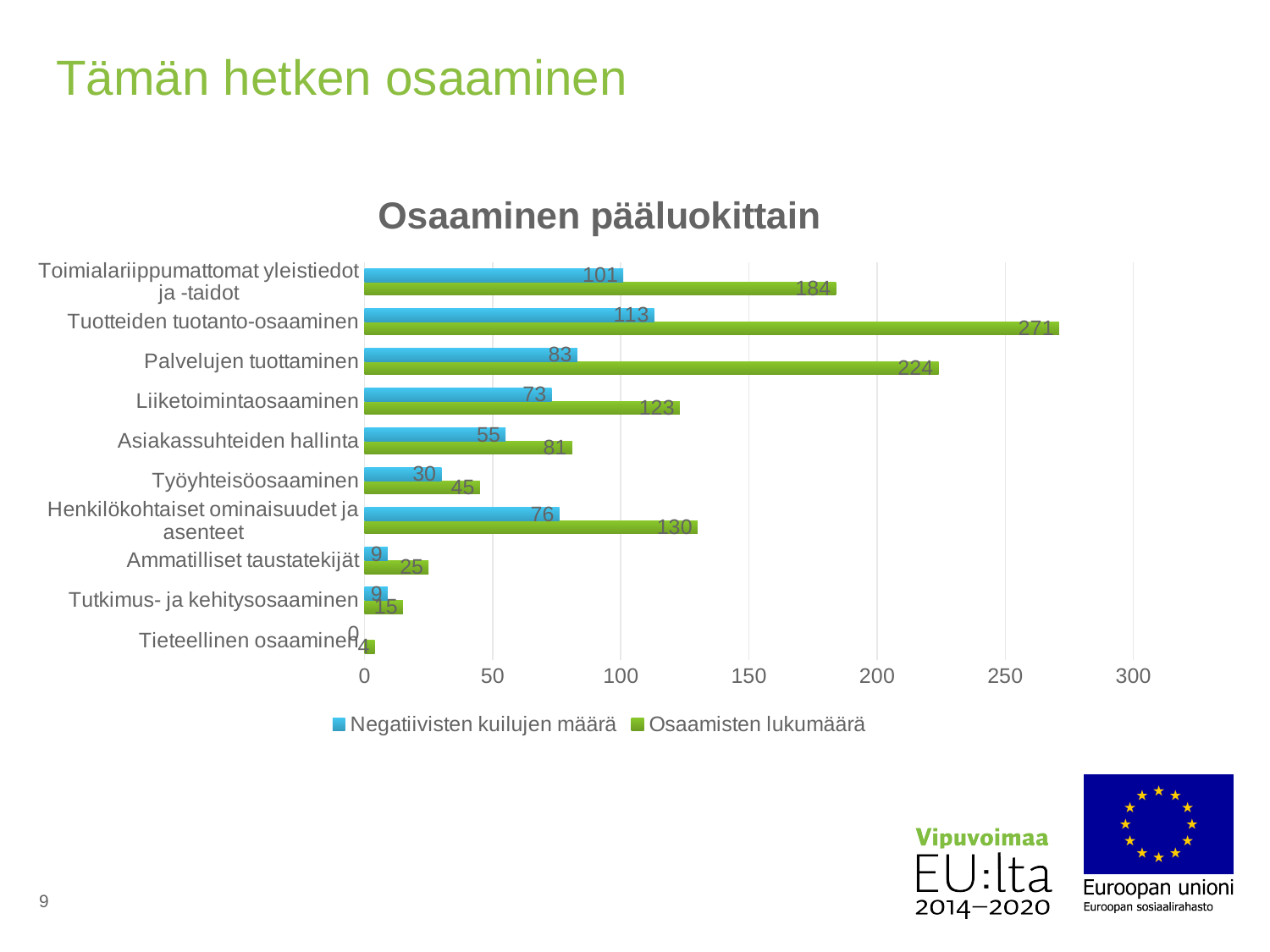
Which category has the lowest Negatiivisten kuilujen määrä value? Tieteellinen osaaminen What is the title of the chart? Osaaminen pääluokittain How many categories are shown on the chart? 10 Which is larger: the Osaamisten lukumäärä value for Palvelujen tuottaminen or for Toimialariippumattomat yleistiedot ja -taidot? Palvelujen tuottaminen Is the Osaamisten lukumäärä value for Asiakassuhteiden hallinta greater or less than 100? less What is the Negatiivisten kuilujen määrä value for Palvelujen tuottaminen? 83 What is the difference between the Osaamisten lukumäärä and Negatiivisten kuilujen määrä values for Liiketoimintaosaaminen? 50 What kind of chart is shown on the slide? Bar chart Which category has the highest Osaamisten lukumäärä value? Tuotteiden tuotanto-osaaminen What is the Osaamisten lukumäärä value for Henkilökohtaiset ominaisuudet ja asenteet? 130 How many series does the legend list? 2 What is the Osaamisten lukumäärä value for Tuotteiden tuotanto-osaaminen? 271